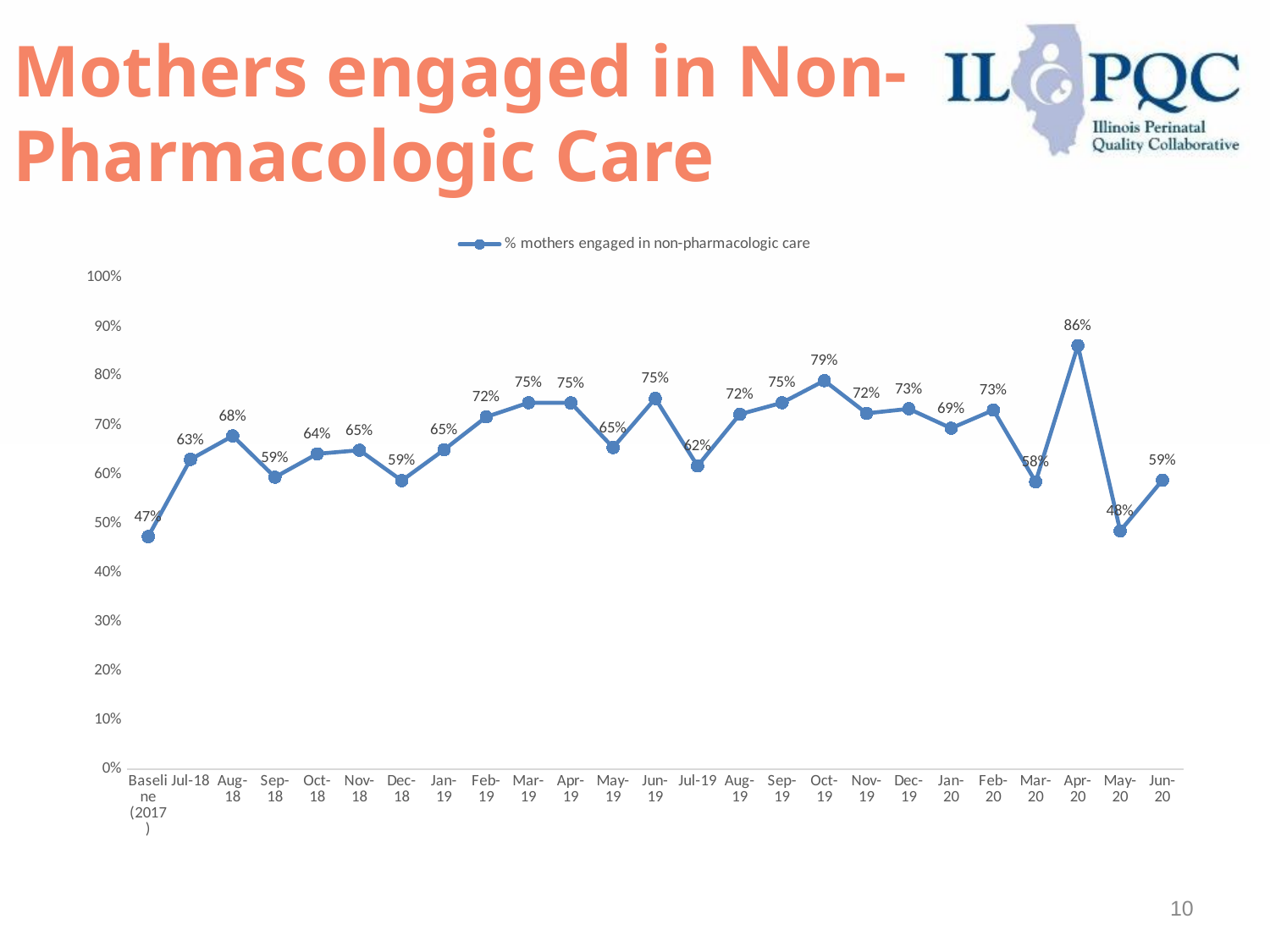
How many data points are plotted on the line? 25 Which data point has the lowest percentage of mothers engaged in non-pharmacologic care? Baseline (2017) What percentage of mothers were engaged in non-pharmacologic care in Apr-20? 86% What value is shown for May-20? 48% Which is higher, the value for Jul-18 or the value for Aug-18? Aug-18 Which month has the highest percentage of mothers engaged in non-pharmacologic care? Apr-20 What value is shown for Oct-19? 79% Is the value for Oct-19 greater or less than 70%? greater What is the baseline (2017) value for % mothers engaged in non-pharmacologic care? 47% How many series does the legend list? 1 What is the difference between the Apr-20 value and the May-20 value? 38% What type of chart is shown on the slide? Line chart